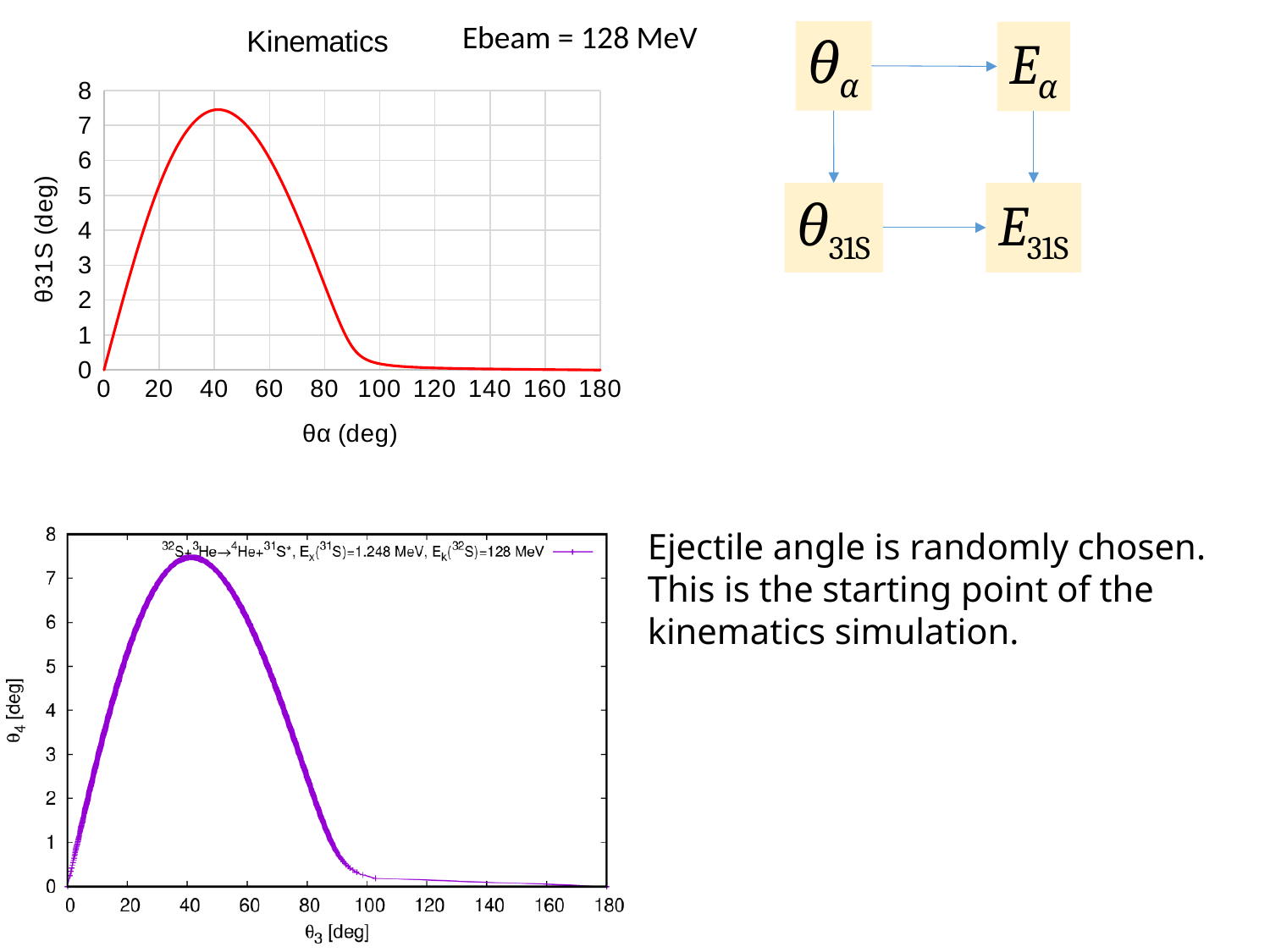
In the top chart titled Kinematics, what kind of chart is shown? line chart In the bottom chart, how many series does the legend list? 1 In the bottom chart, is the value at θ3 = 120 greater or less than 1? less In the top chart titled Kinematics, is the value at θα = 20 greater or less than 4? greater In the top chart titled Kinematics, does the curve rise or fall as θα goes from 0 to 40? rise In the top chart titled Kinematics, is the value at θα = 40 greater or less than 7? greater In the top chart titled Kinematics, what is the highest tick value shown on the x axis? 180 In the top chart titled Kinematics, what is the label of the y axis? θ31S (deg) In the top chart titled Kinematics, what is the label of the x axis? θα (deg) In the top chart titled Kinematics, does the curve rise or fall as θα goes from 40 to 80? fall